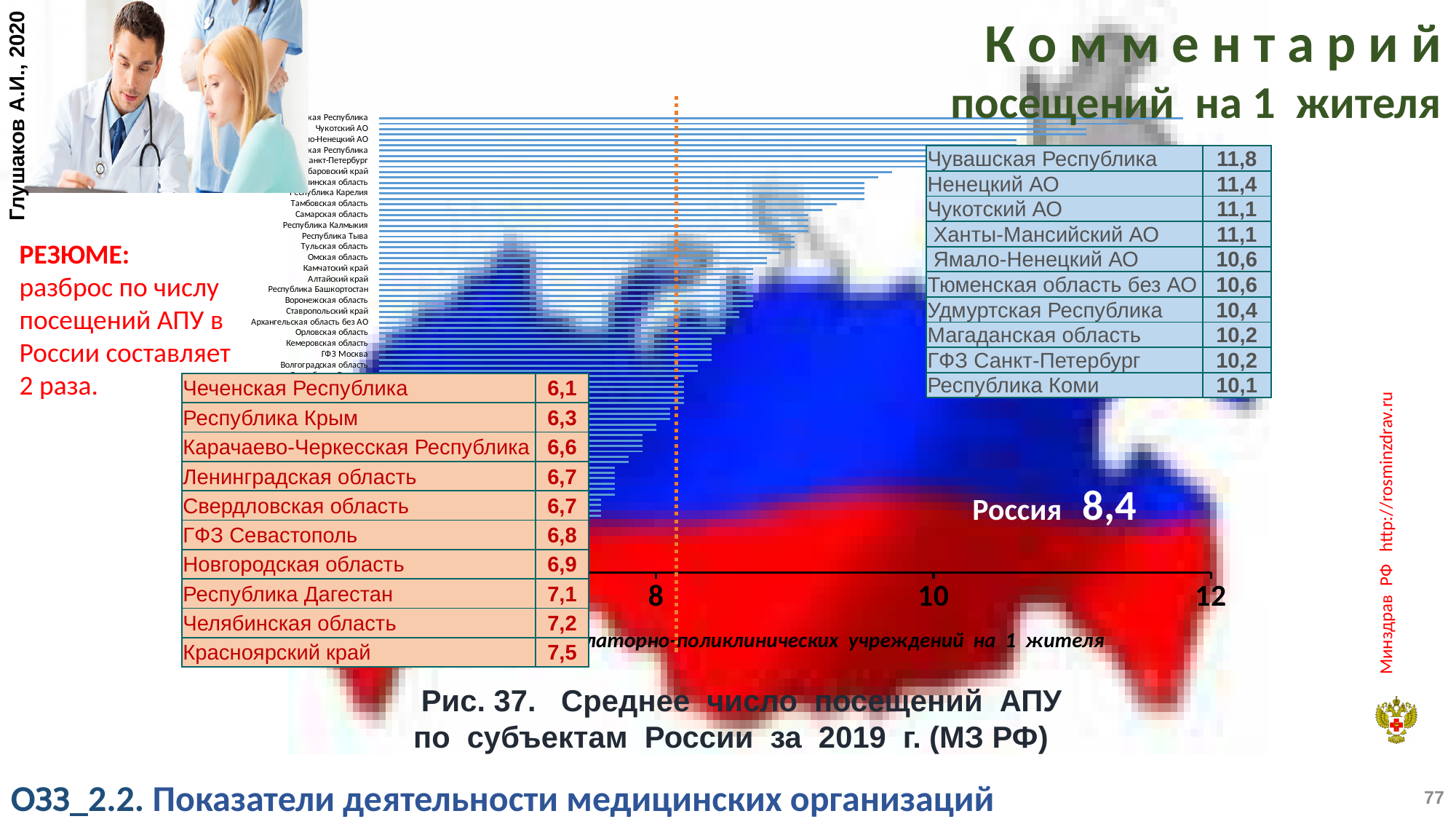
What is the difference between the values for Чувашская Республика and Чеченская Республика? 5,7 What is the average number of outpatient visits per resident for Чувашская Республика? 11,8 What is the difference between the values for Красноярский край and Челябинская область? 0,3 What kind of chart is shown on the slide? bar chart How many regions are listed in the table of lowest values (orange table)? 10 Which region has the highest number of visits per resident? Чувашская Республика What is the figure number and title of the chart? Рис. 37. Среднее число посещений АПУ по субъектам России за 2019 г. (МЗ РФ) What is the value shown for Россия as a whole? 8,4 What is the value shown for Чеченская Республика? 6,1 Is the value for Россия greater or less than 8? greater Which region has the lowest number of visits per resident? Чеченская Республика Which has a higher value, Ненецкий АО or Чукотский АО? Ненецкий АО